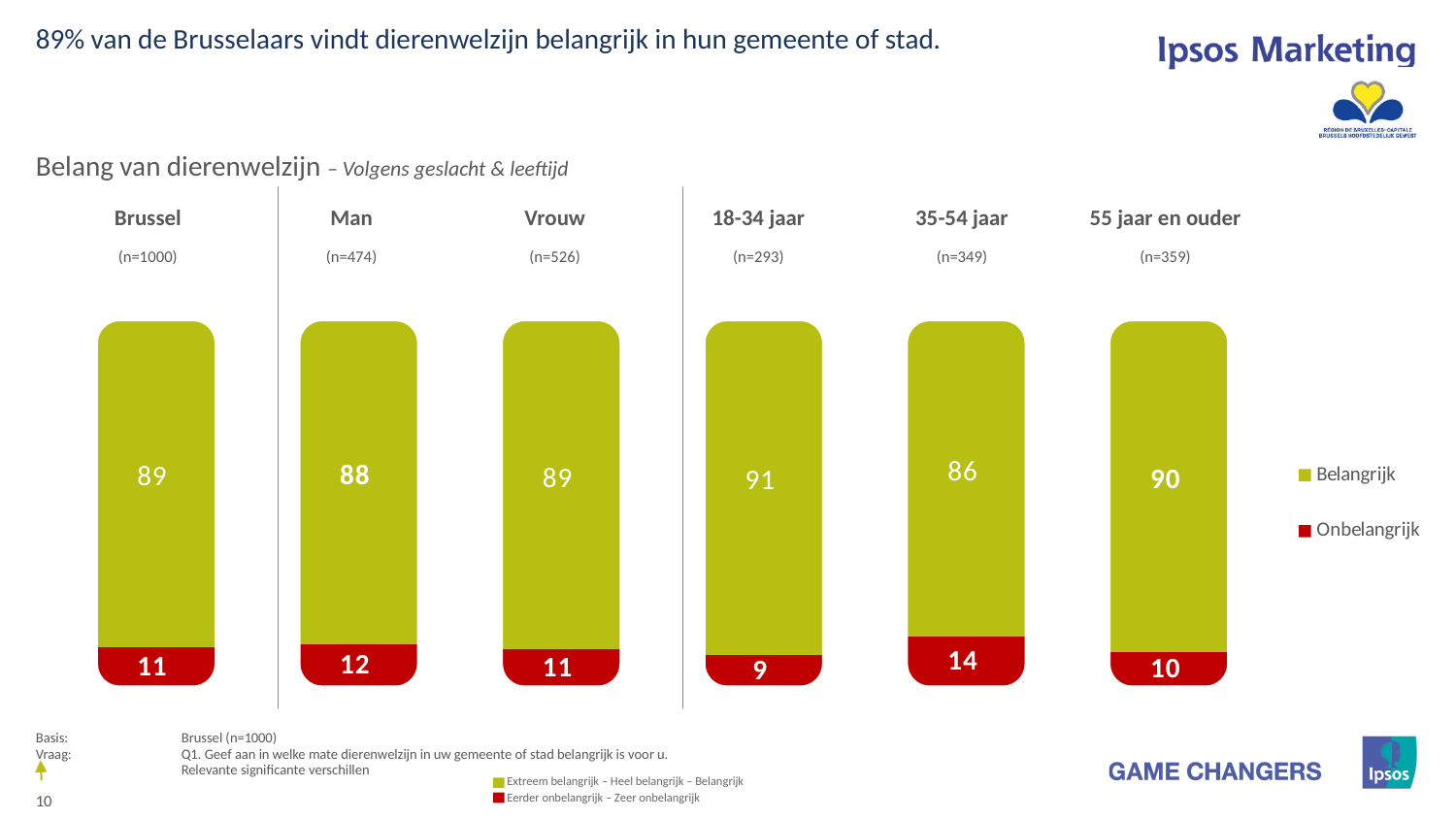
What is the total of the stacked bar for 55 jaar en ouder? 100 What is the 'Onbelangrijk' value for the 35-54 jaar group? 14 How many series does the legend list? 2 How many groups (bars) are shown in the chart? 6 What is the sample size (n) shown for the Vrouw group? n=526 Which group has the highest 'Belangrijk' value? 18-34 jaar What kind of chart is shown on the slide? Stacked bar chart Which has a larger 'Belangrijk' value, Man or Vrouw? Vrouw What is the 'Belangrijk' value for Man? 88 What is the 'Belangrijk' value for the 18-34 jaar group? 91 What is the difference between the 'Onbelangrijk' values for 35-54 jaar and 18-34 jaar? 5 Which group has the lowest 'Belangrijk' value? 35-54 jaar